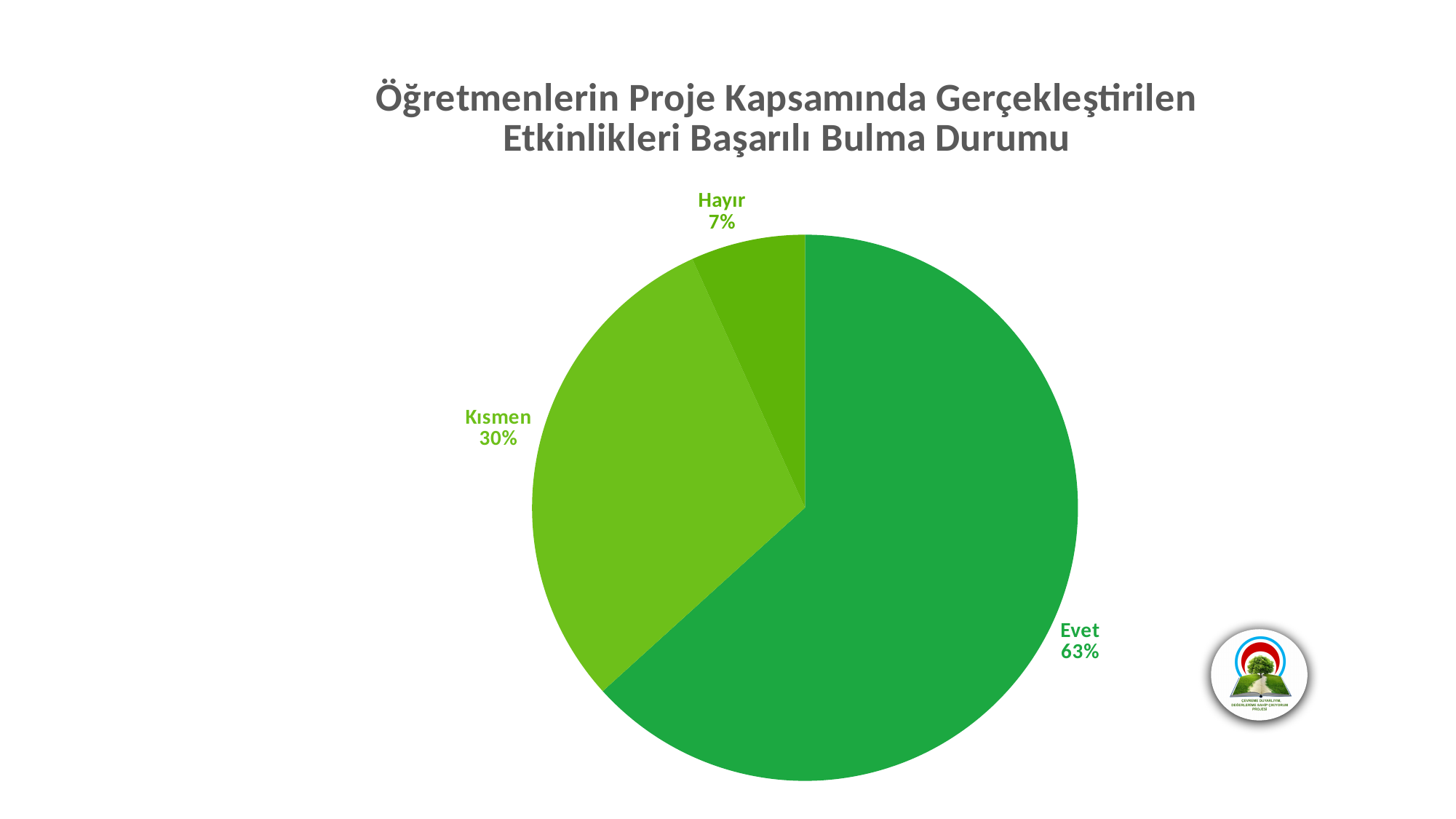
What kind of chart is shown on the slide? Pie chart What is the difference in percentage points between the Evet and Kısmen slices? 33 What is the difference in percentage points between the Kısmen and Hayır slices? 23 Which slice is larger, Kısmen or Hayır? Kısmen Which category has the largest share of the pie? Evet What is the title of the chart? Öğretmenlerin Proje Kapsamında Gerçekleştirilen Etkinlikleri Başarılı Bulma Durumu What is the combined share of the Kısmen and Hayır slices? 37% How many slices does the pie chart have? 3 What percentage of the pie is labelled Hayır? 7% Which category has the smallest share of the pie? Hayır What percentage of the pie is labelled Kısmen? 30% What percentage of the pie is labelled Evet? 63%